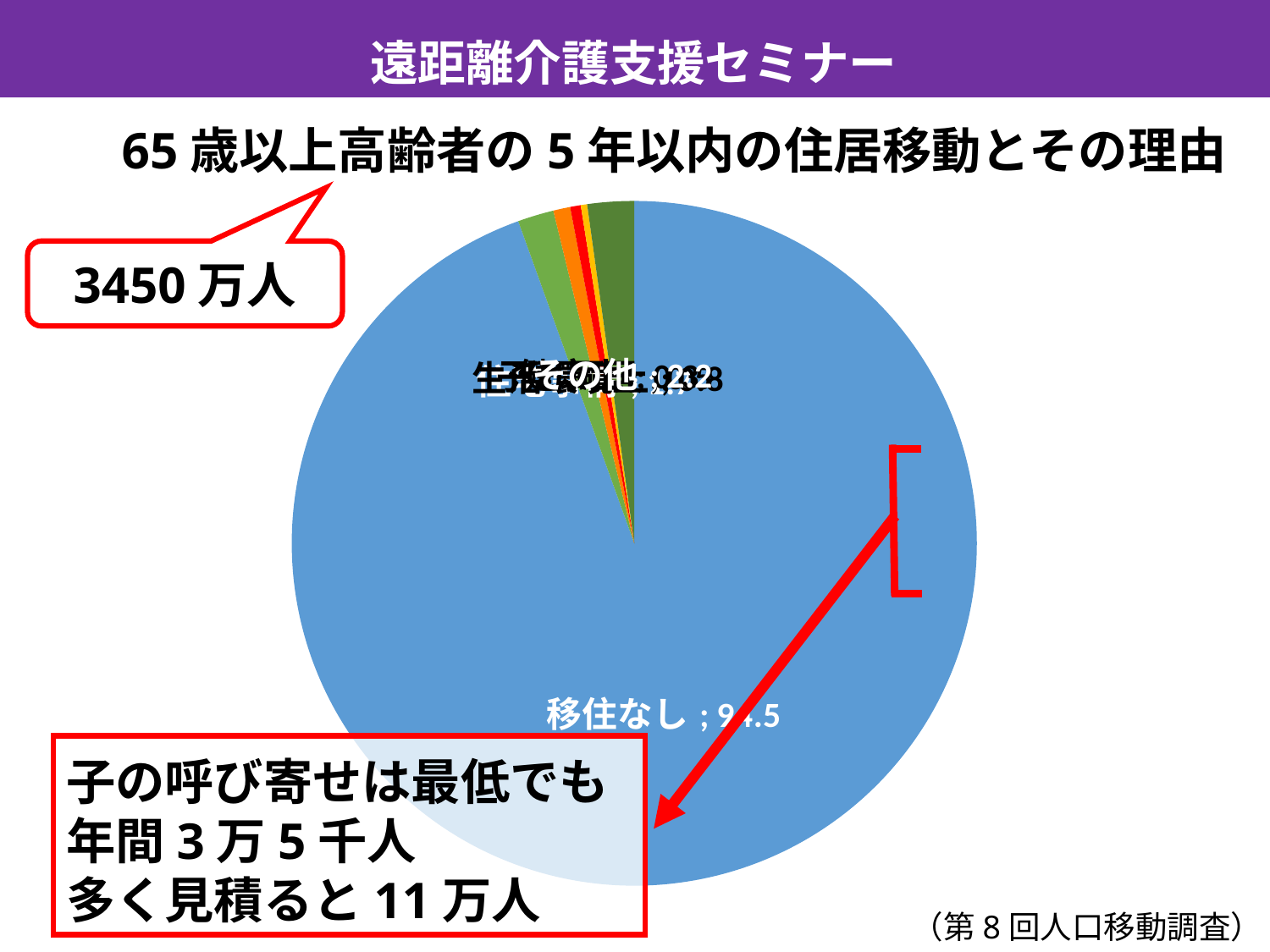
What value is shown for 移住なし in the pie chart? 94.5 Which is larger, the slice for 移住なし or the slice for その他? 移住なし Does the 移住なし slice make up more or less than half of the pie? more Is the value for 移住なし greater or less than 90? greater What is the title of the chart? 65歳以上高齢者の5年以内の住居移動とその理由 Which category has the largest slice of the pie chart? 移住なし What colour is the 移住なし slice of the pie chart? blue What kind of chart is shown on the slide? pie chart